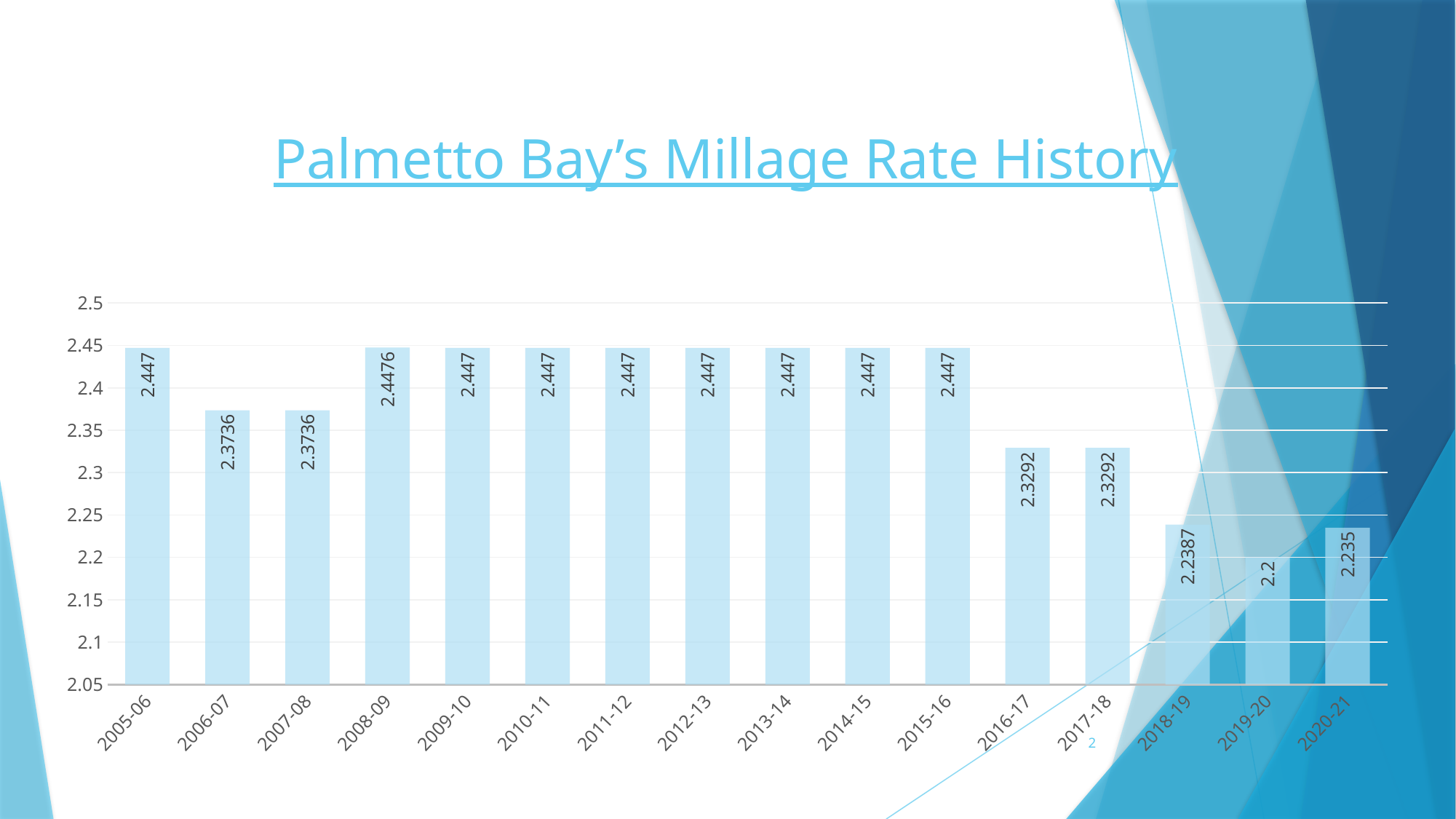
What is the difference between the millage rate in 2016-17 and in 2018-19? 0.0905 What is the difference between the millage rate in 2005-06 and in 2019-20? 0.247 What is the millage rate for 2005-06? 2.447 What kind of chart is shown on the slide? bar chart Which is larger, the millage rate for 2007-08 or for 2017-18? 2007-08 What is the millage rate for 2006-07? 2.3736 What is the millage rate for 2018-19? 2.2387 What is the millage rate for 2016-17? 2.3292 What is the millage rate for 2020-21? 2.235 Is the millage rate for 2018-19 greater or less than 2.25? less Which year has the lowest millage rate? 2019-20 How many fiscal years are shown on the x axis? 16